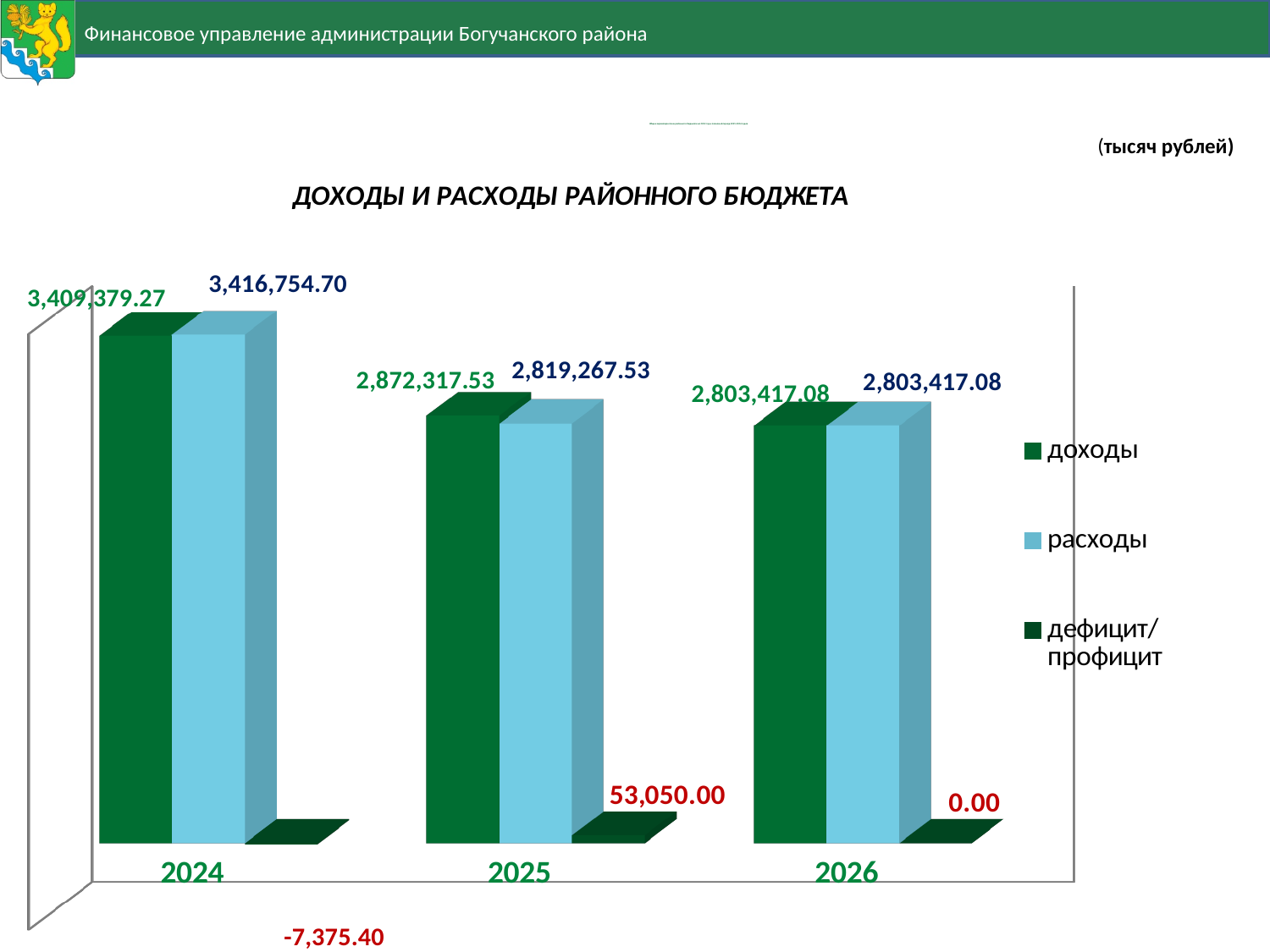
What is the value of дефицит/профицит for 2025? 53,050.00 In 2024, which is larger: доходы or расходы? расходы What is the difference between доходы in 2024 and доходы in 2025? 537,061.74 What is the value of расходы for 2025? 2,819,267.53 What is the value of дефицит/профицит for 2024? -7,375.40 Which year has the highest value of доходы? 2024 How many years are shown on the x axis? 3 What is the value of доходы for 2024? 3,409,379.27 How many series does the legend list? 3 What kind of chart is shown on the slide? bar chart Which year has the lowest value of расходы? 2026 What is the difference between доходы and расходы in 2025? 53,050.00